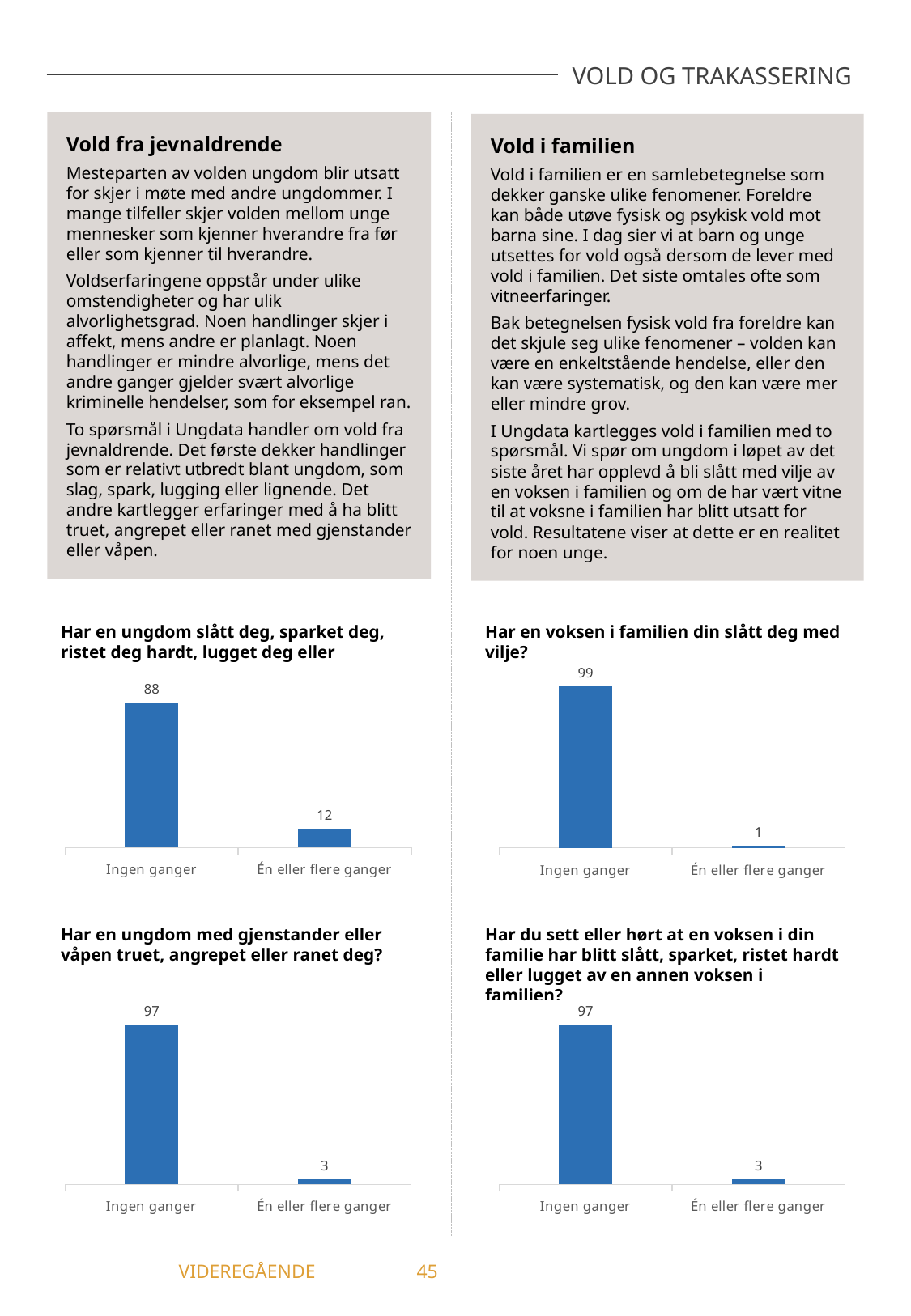
In the bottom-right chart ("Har du sett eller hørt at en voksen i din familie har blitt slått..."), what is the value for "Ingen ganger"? 97 What kind of chart is the bottom-left chart ("Har en ungdom med gjenstander eller våpen truet, angrepet eller ranet deg?")? Bar chart How many categories does the top-left chart ("Har en ungdom slått deg, sparket deg...") show? 2 In the top-right chart ("Har en voksen i familien din slått deg med vilje?"), what is the value for "Én eller flere ganger"? 1 In the bottom-right chart ("Har du sett eller hørt at en voksen i din familie har blitt slått..."), which category has the highest value? Ingen ganger In the top-left chart ("Har en ungdom slått deg, sparket deg..."), what is the difference between "Ingen ganger" and "Én eller flere ganger"? 76 In the top-right chart ("Har en voksen i familien din slått deg med vilje?"), what is the value for "Ingen ganger"? 99 In the top-left chart ("Har en ungdom slått deg, sparket deg..."), what is the value for "Ingen ganger"? 88 In the bottom-left chart ("Har en ungdom med gjenstander eller våpen truet, angrepet eller ranet deg?"), what is the value for "Én eller flere ganger"? 3 In the top-left chart ("Har en ungdom slått deg, sparket deg..."), what is the value for "Én eller flere ganger"? 12 In the bottom-left chart ("Har en ungdom med gjenstander eller våpen truet, angrepet eller ranet deg?"), what is the value for "Ingen ganger"? 97 In the top-right chart ("Har en voksen i familien din slått deg med vilje?"), which category has the lowest value? Én eller flere ganger